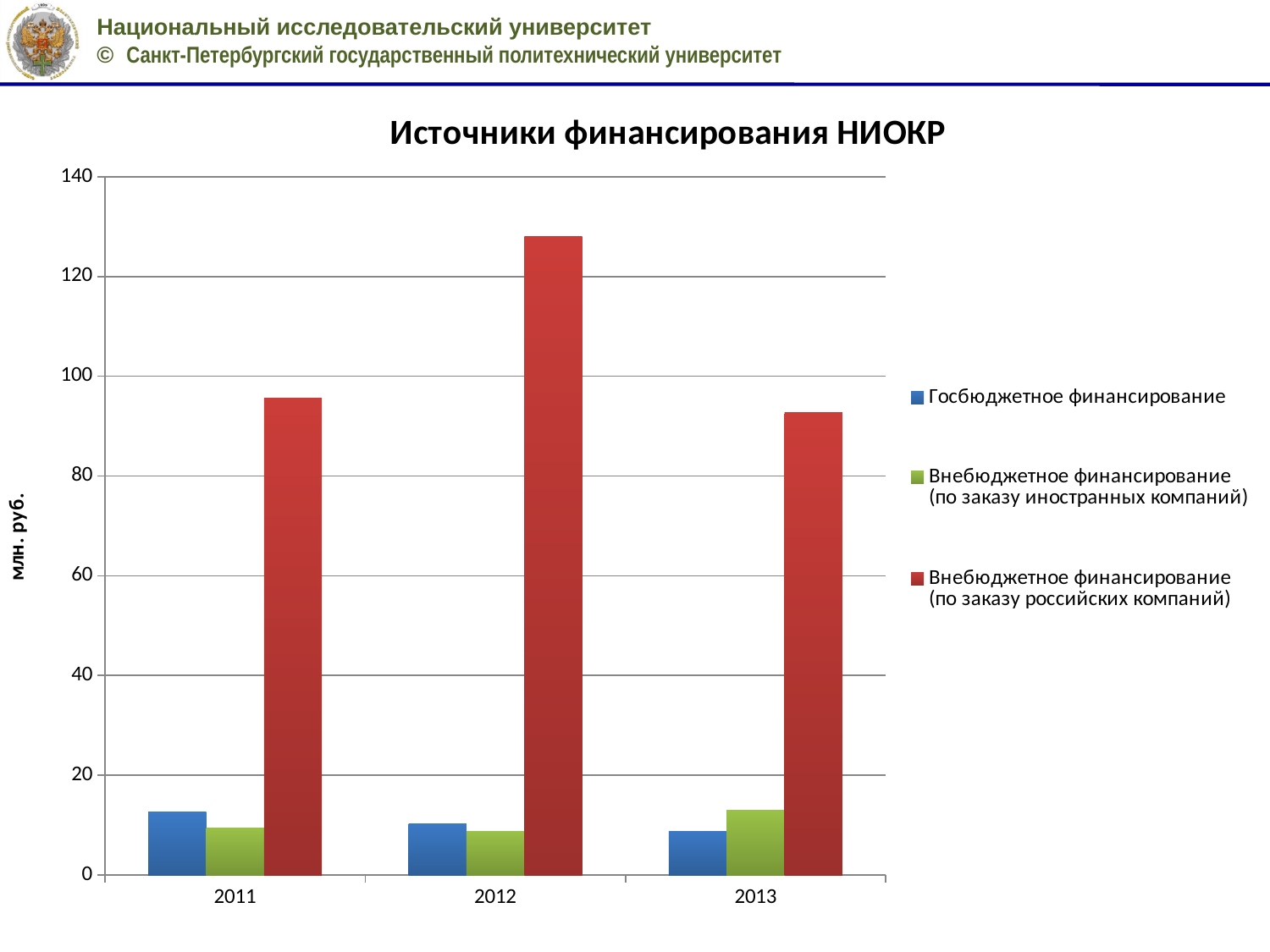
What is the label of the vertical axis? млн. руб. What kind of chart is shown on the slide? bar chart How many years are shown on the x axis? 3 Is the value for Внебюджетное финансирование (по заказу российских компаний) in 2013 greater or less than 100? less In 2013, which is larger: Госбюджетное финансирование or Внебюджетное финансирование (по заказу иностранных компаний)? Внебюджетное финансирование (по заказу иностранных компаний) Is the value for Внебюджетное финансирование (по заказу российских компаний) in 2012 greater or less than 120? greater Which series has the largest value in 2011? Внебюджетное финансирование (по заказу российских компаний) What is the title of the chart? Источники финансирования НИОКР Is the value for Госбюджетное финансирование in 2011 greater or less than 20? less In which year is the value for Госбюджетное финансирование lowest? 2013 In which year is the value for Внебюджетное финансирование (по заказу российских компаний) highest? 2012 How many series does the legend list? 3